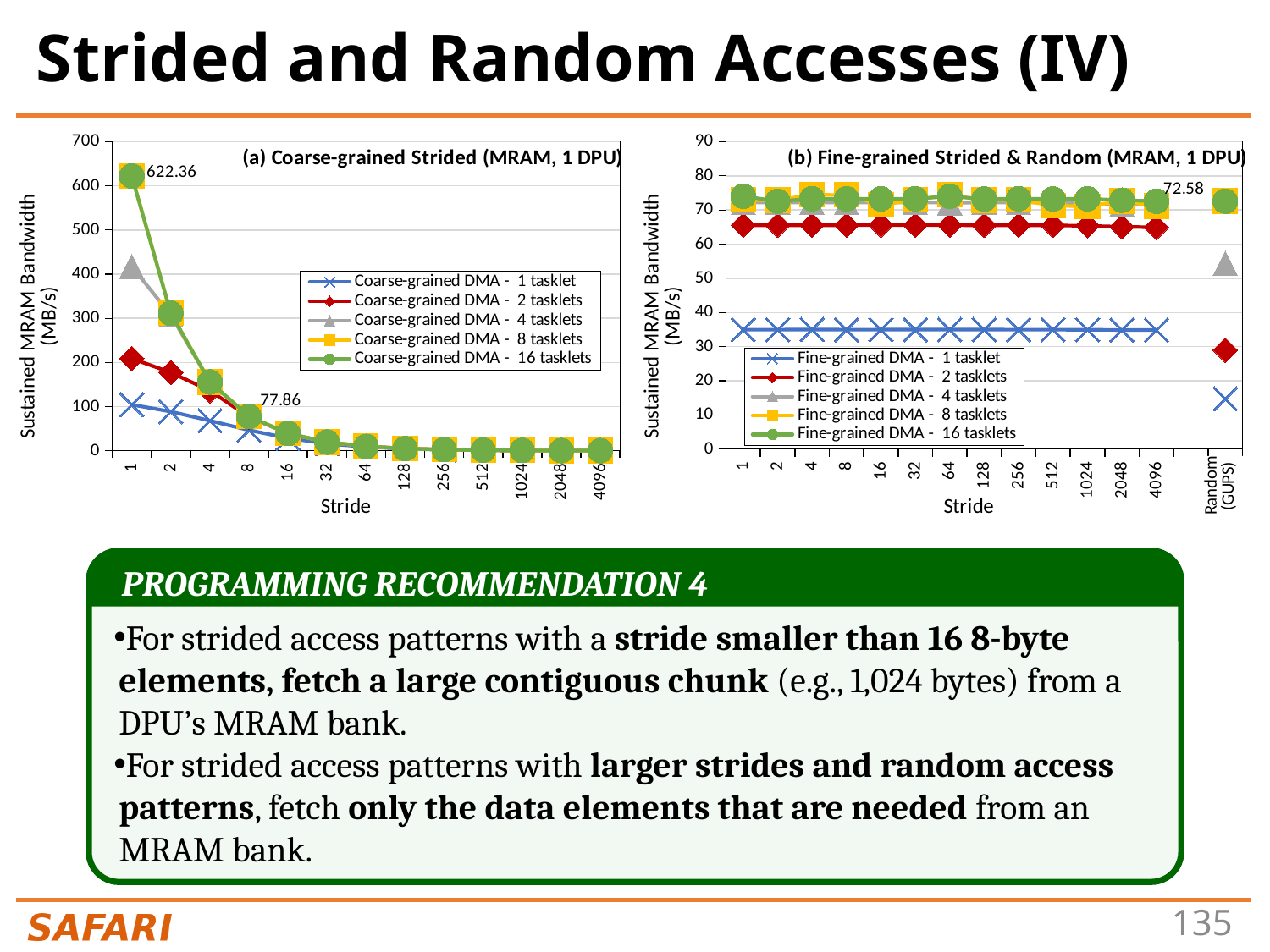
In chart (a) Coarse-grained Strided, is the value for Coarse-grained DMA - 2 tasklets at stride 1 greater or less than 300? less How many series does the legend of chart (a) Coarse-grained Strided list? 5 What is the y-axis label of chart (a) Coarse-grained Strided (MRAM, 1 DPU)? Sustained MRAM Bandwidth (MB/s) What kind of chart is chart (a) Coarse-grained Strided (MRAM, 1 DPU)? Line chart How many series does the legend of chart (b) Fine-grained Strided & Random list? 5 How many categories are shown on the x axis of chart (b) Fine-grained Strided & Random, including Random (GUPS)? 14 In chart (b) Fine-grained Strided & Random, at Random (GUPS), which is larger: Fine-grained DMA - 4 tasklets or Fine-grained DMA - 1 tasklet? Fine-grained DMA - 4 tasklets How many stride values are shown on the x axis of chart (a) Coarse-grained Strided? 13 In chart (b) Fine-grained Strided & Random, is the value for Fine-grained DMA - 1 tasklet at stride 1 greater or less than 40? less In chart (a) Coarse-grained Strided, does the Coarse-grained DMA - 16 tasklets series rise or fall as the stride increases? Fall In chart (b) Fine-grained Strided & Random (MRAM, 1 DPU), what is the labeled value shown at stride 4096? 72.58 In chart (a) Coarse-grained Strided (MRAM, 1 DPU), what is the labeled sustained MRAM bandwidth for Coarse-grained DMA - 16 tasklets at stride 1? 622.36